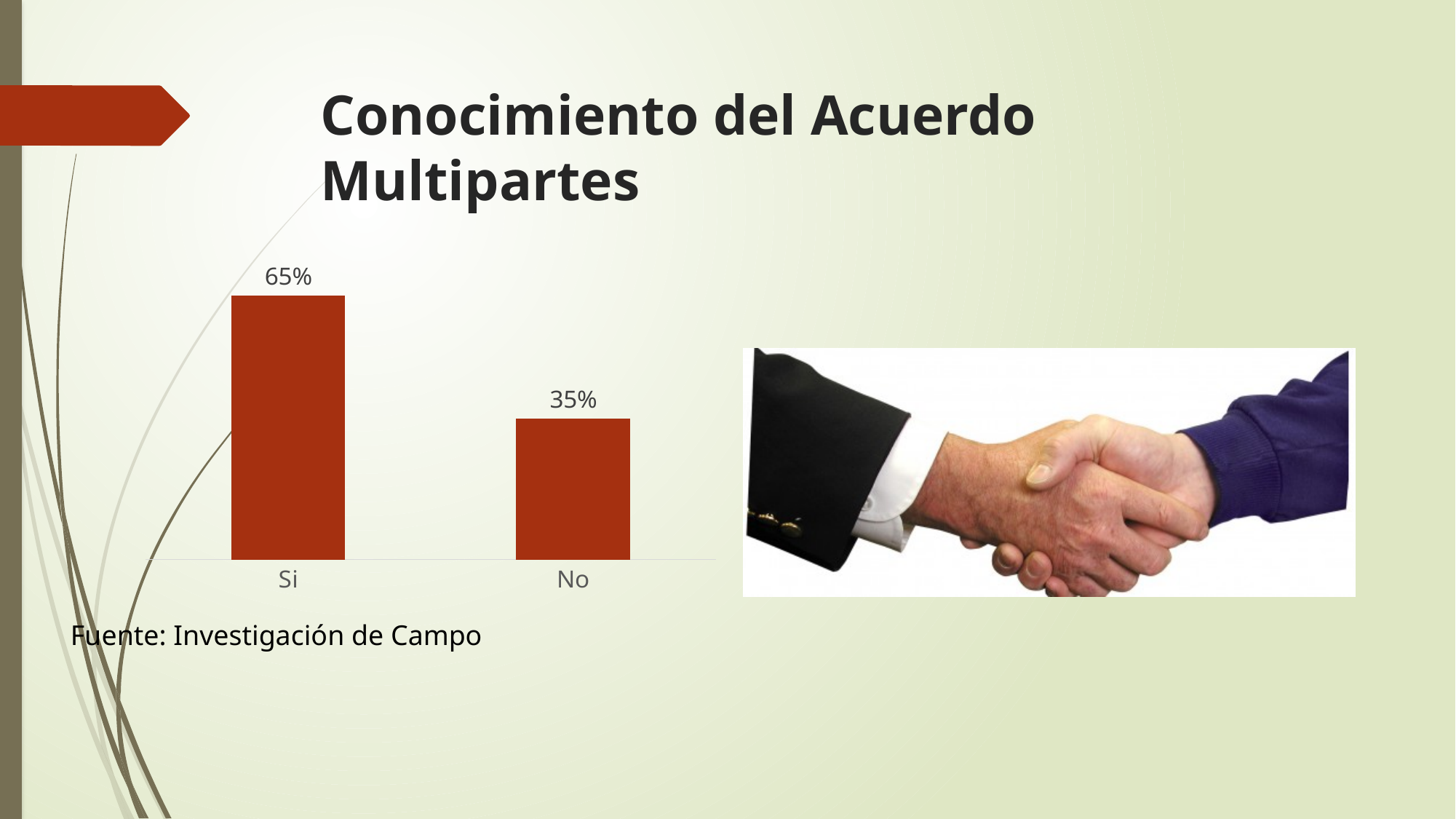
What is the value for No? 35% What is the difference between the values for Si and No? 30% Which category has the lowest value? No Which category has the highest value? Si What is the value for Si? 65% What kind of chart is shown on the slide? Bar chart What is the total of the values for Si and No? 100% How many categories are shown in the chart? 2 Which is larger, the value for Si or the value for No? Si Do the values rise or fall from Si to No? Fall What source is cited below the chart? Investigación de Campo What is the title of the slide containing the chart? Conocimiento del Acuerdo Multipartes